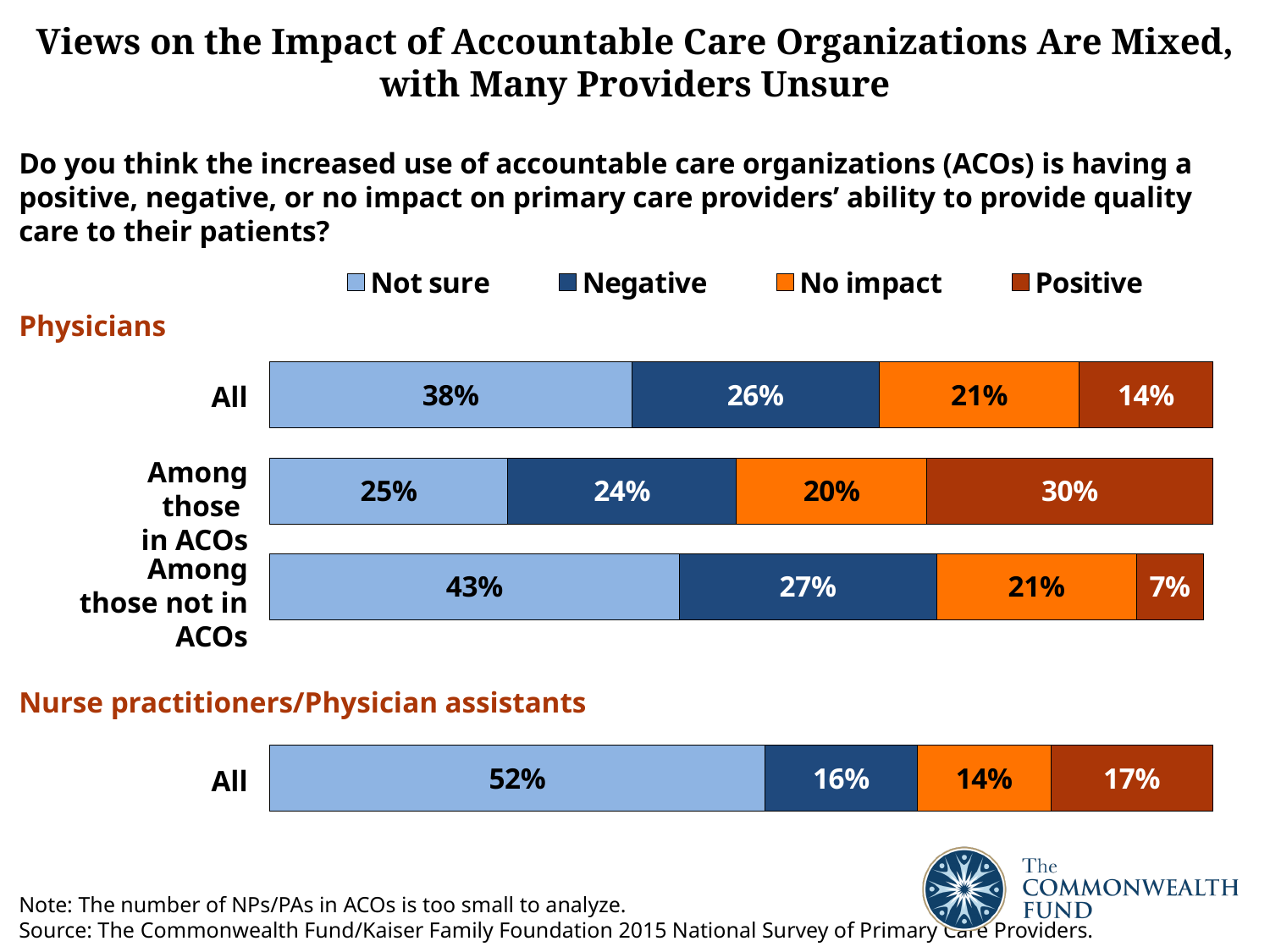
In the Physicians chart, what is the total of the 'All' bar's segments? 99% In the Physicians chart, which group has the lowest 'Positive' share? Among those not in ACOs In the Physicians chart, which group has the highest 'Not sure' share? Among those not in ACOs In the Nurse practitioners/Physician assistants chart, which is larger: the 'Negative' share or the 'Positive' share? Positive In the Physicians chart, what is the difference between the 'Positive' share for those in ACOs and those not in ACOs? 23 percentage points In the Physicians chart, what percentage of physicians in ACOs said ACOs have a positive impact? 30% In the Physicians chart, what percentage of all physicians said 'Not sure'? 38% In the Physicians chart, what percentage of physicians not in ACOs said ACOs have a positive impact? 7% How many bars are in the Physicians chart? 3 How many series does the legend list? 4 In the Nurse practitioners/Physician assistants chart, what percentage said 'Not sure'? 52% What kind of chart is used on this slide? Stacked bar chart